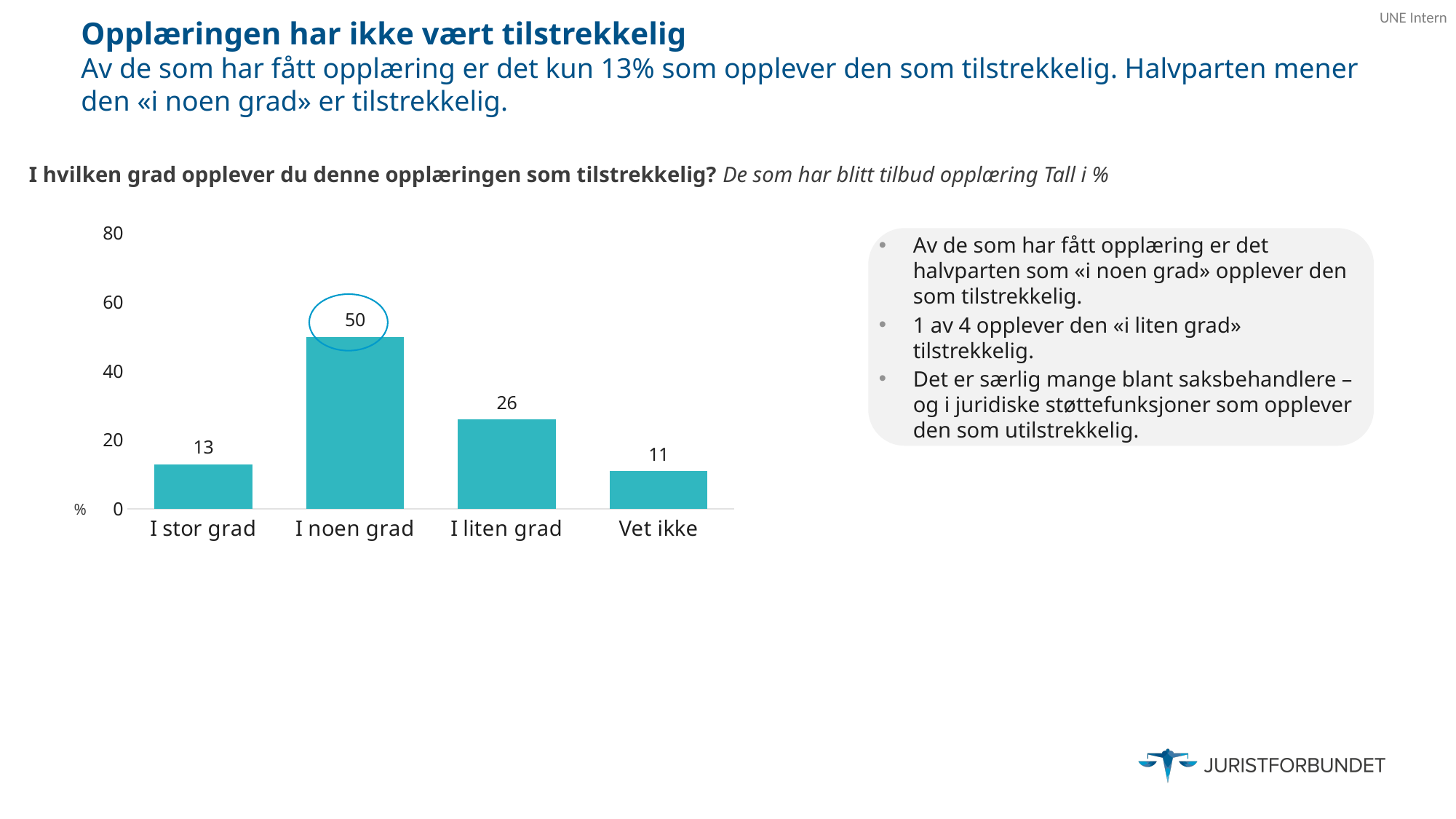
Which category has the highest value? I noen grad What kind of chart is shown on the slide? bar chart What is the value for "I liten grad"? 26 Which bar's data label is circled on the chart? I noen grad Which category has the lowest value? Vet ikke Is the value for "I liten grad" greater or less than 20? greater What is the difference between the values for "I noen grad" and "I liten grad"? 24 What is the value for "Vet ikke"? 11 How many categories are shown on the x axis? 4 What is the value for "I stor grad"? 13 Which is larger, the value for "I stor grad" or the value for "Vet ikke"? I stor grad What is the value for "I noen grad"? 50